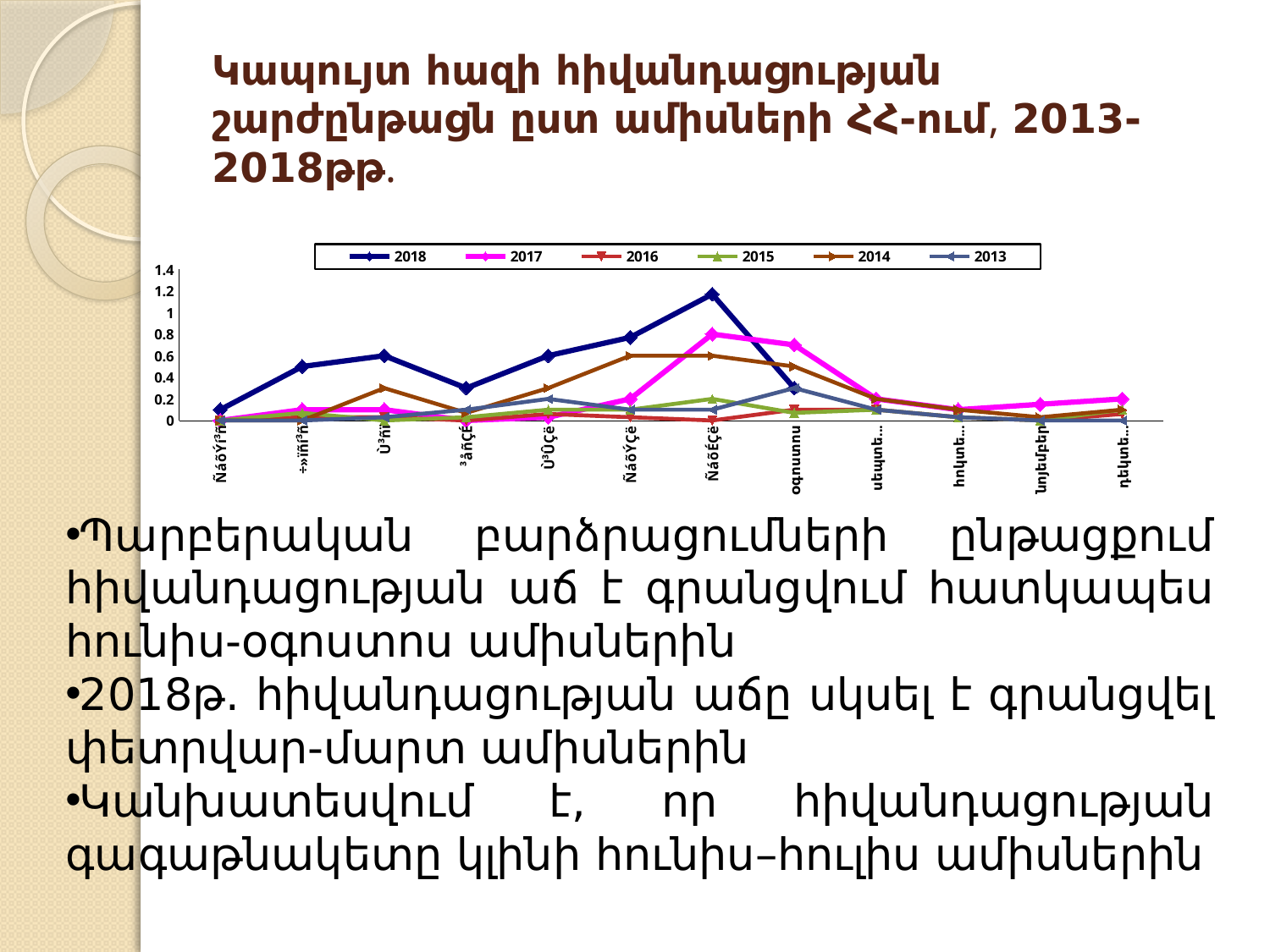
Is the value for 2017 in նոյեմբեր greater or less than 0.4? less In օգոստոս, which series has the larger value, 2017 or 2018? 2017 What is the highest tick value shown on the y axis? 1.4 How many series does the legend list? 6 Which series is listed first in the legend? 2018 Is the peak value of the 2018 series greater or less than 1? greater Is the value for 2018 in օգոստոս greater or less than 0.6? less Which series reaches the highest value on the chart? 2018 What kind of chart is shown on the slide? line chart How many points (months) are plotted along the x axis? 12